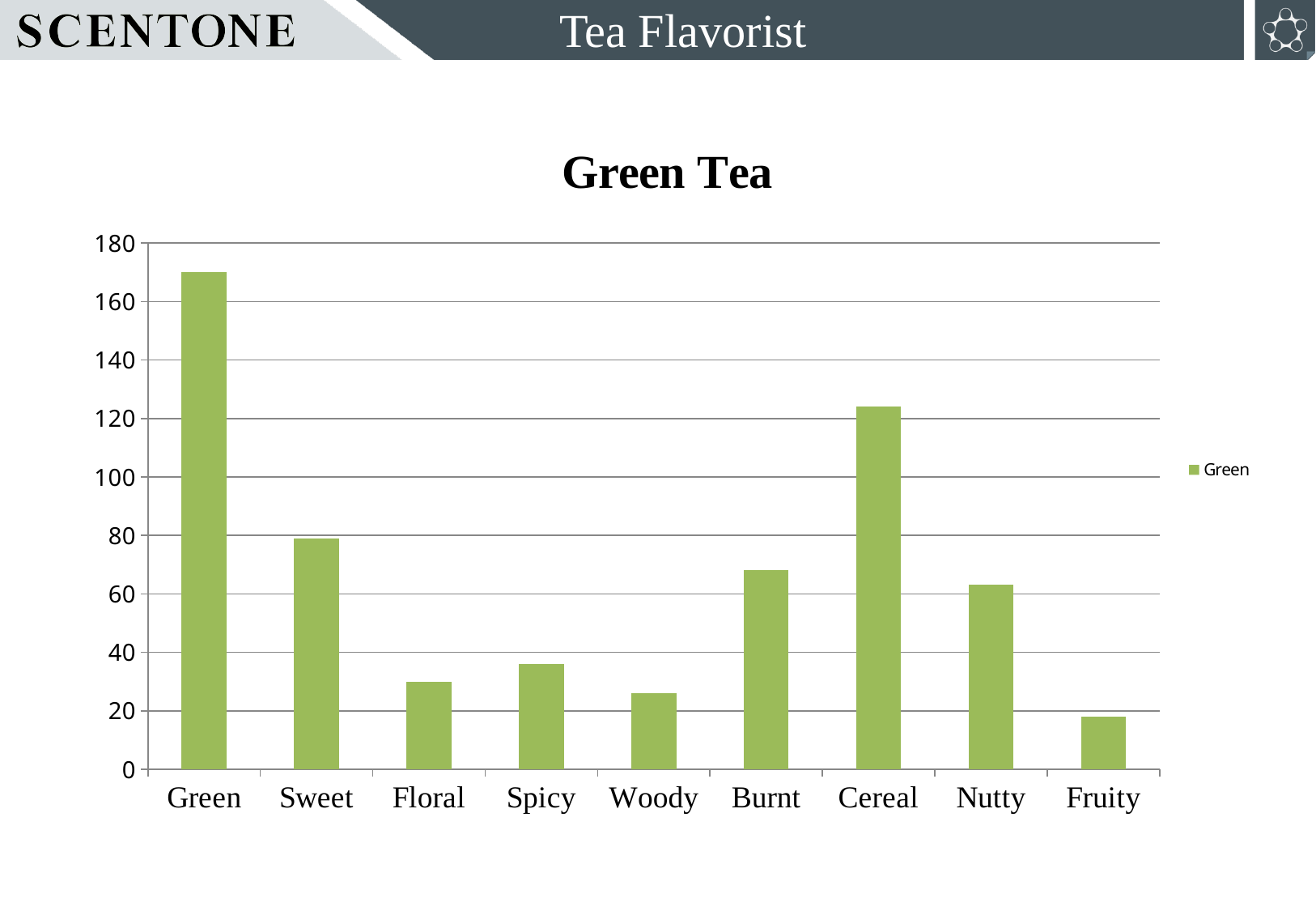
Which is larger, the value for Spicy or the value for Cereal? Cereal Which category has the highest value? Green Which is larger, the value for Burnt or the value for Nutty? Burnt How many series does the legend list? 1 Which category has the lowest value? Fruity How many categories are shown on the x axis of the chart? 9 What kind of chart is shown on the slide? bar chart Is the value for Green greater or less than 160? greater Is the value for Sweet greater or less than 100? less Is the value for Cereal greater or less than 120? greater What is the title of the chart? Green Tea